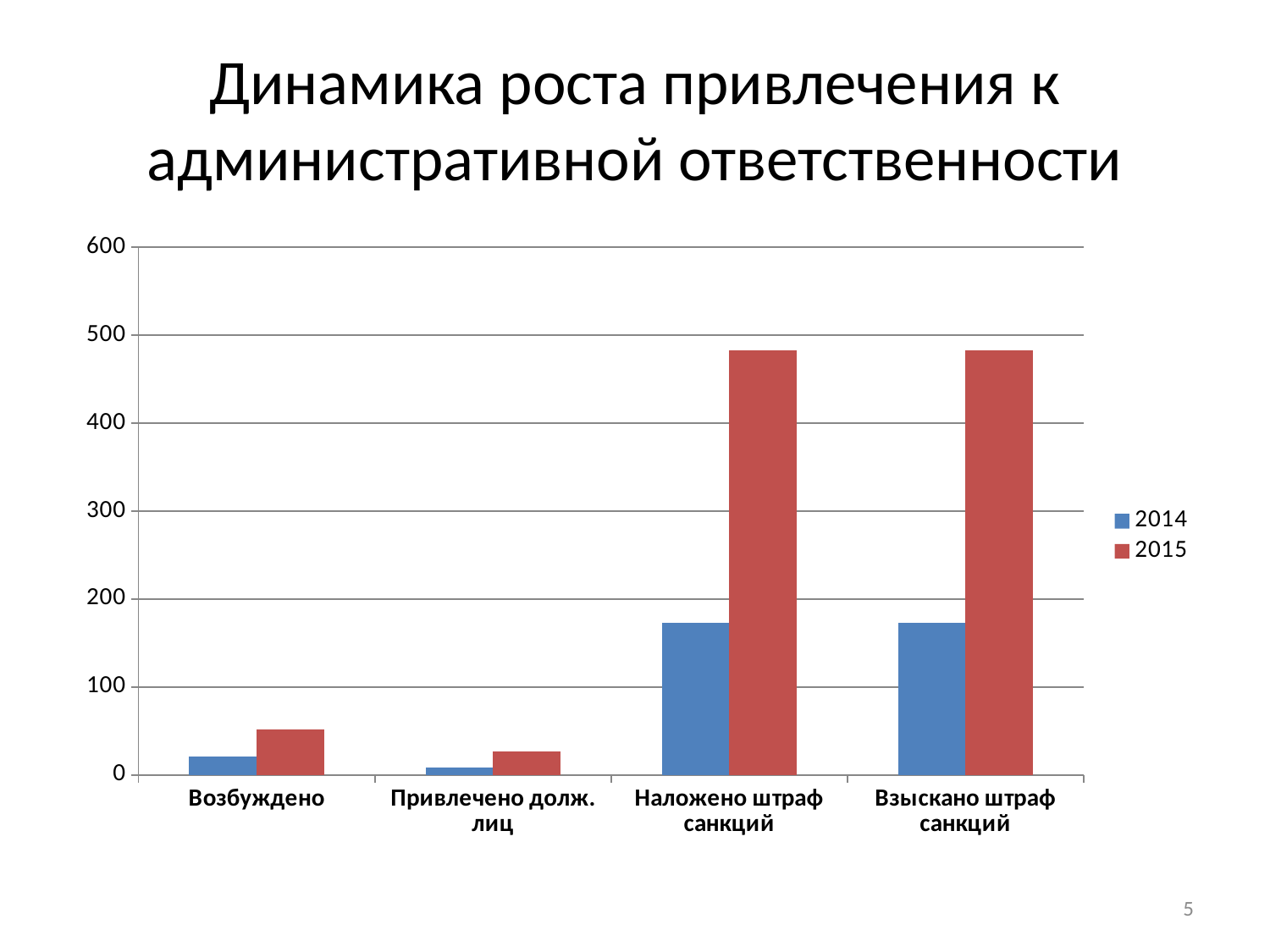
Which years are listed in the chart's legend? 2014 and 2015 Is the 2015 value for Взыскано штраф санкций greater or less than 500? less Which category has the lowest value for 2014? Привлечено долж. лиц What kind of chart is shown on the slide? bar chart For Возбуждено, which year has the larger value, 2014 or 2015? 2015 For Наложено штраф санкций, which year has the larger value, 2014 or 2015? 2015 Is the 2014 value for Наложено штраф санкций greater or less than 200? less Is the 2015 value for Возбуждено greater or less than 100? less Which category has the lowest value for 2015? Привлечено долж. лиц How many series does the chart's legend list? 2 How many categories are shown on the x axis of the chart? 4